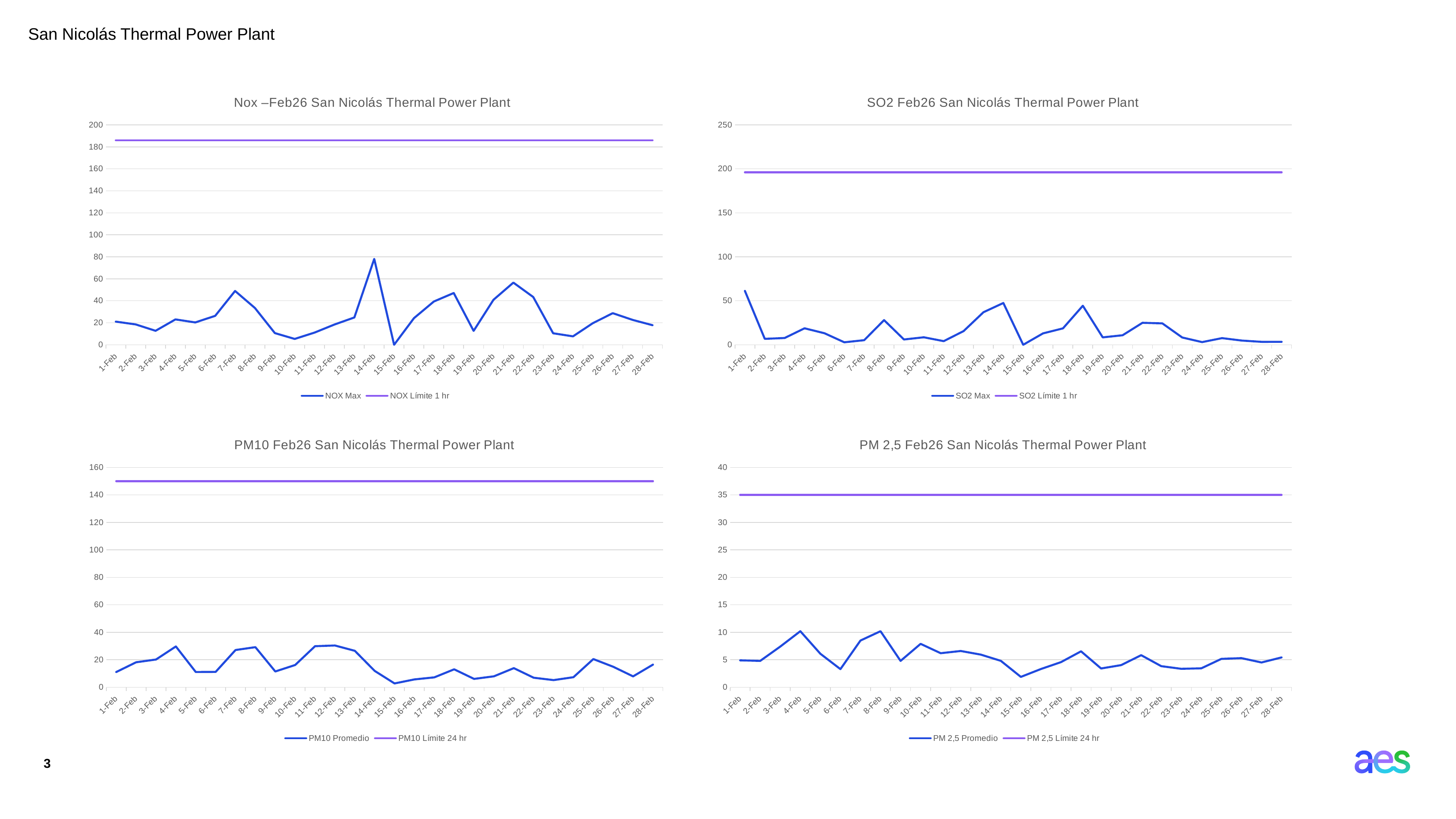
How many series does the legend of the SO2 Feb26 San Nicolás Thermal Power Plant chart list? 2 In the SO2 Feb26 San Nicolás Thermal Power Plant chart, on which date is SO2 Max highest? 1-Feb What kind of chart is the Nox –Feb26 San Nicolás Thermal Power Plant chart? line chart In the Nox –Feb26 San Nicolás Thermal Power Plant chart, which date has the larger NOX Max value, 7-Feb or 10-Feb? 7-Feb How many dates are plotted along the x axis of the PM10 Feb26 San Nicolás Thermal Power Plant chart? 28 In the PM10 Feb26 San Nicolás Thermal Power Plant chart, is the PM10 Límite 24 hr line greater or less than 140? greater In the Nox –Feb26 San Nicolás Thermal Power Plant chart, is the NOX Max value on 14-Feb greater or less than 60? greater In the PM 2,5 Feb26 San Nicolás Thermal Power Plant chart, what value does the PM 2,5 Límite 24 hr line sit at? 35 In the Nox –Feb26 San Nicolás Thermal Power Plant chart, on which date is NOX Max highest? 14-Feb What are the two legend entries of the PM10 Feb26 San Nicolás Thermal Power Plant chart? PM10 Promedio and PM10 Límite 24 hr In the PM10 Feb26 San Nicolás Thermal Power Plant chart, on which date is PM10 Promedio lowest? 15-Feb In the PM 2,5 Feb26 San Nicolás Thermal Power Plant chart, on which date is PM 2,5 Promedio lowest? 15-Feb